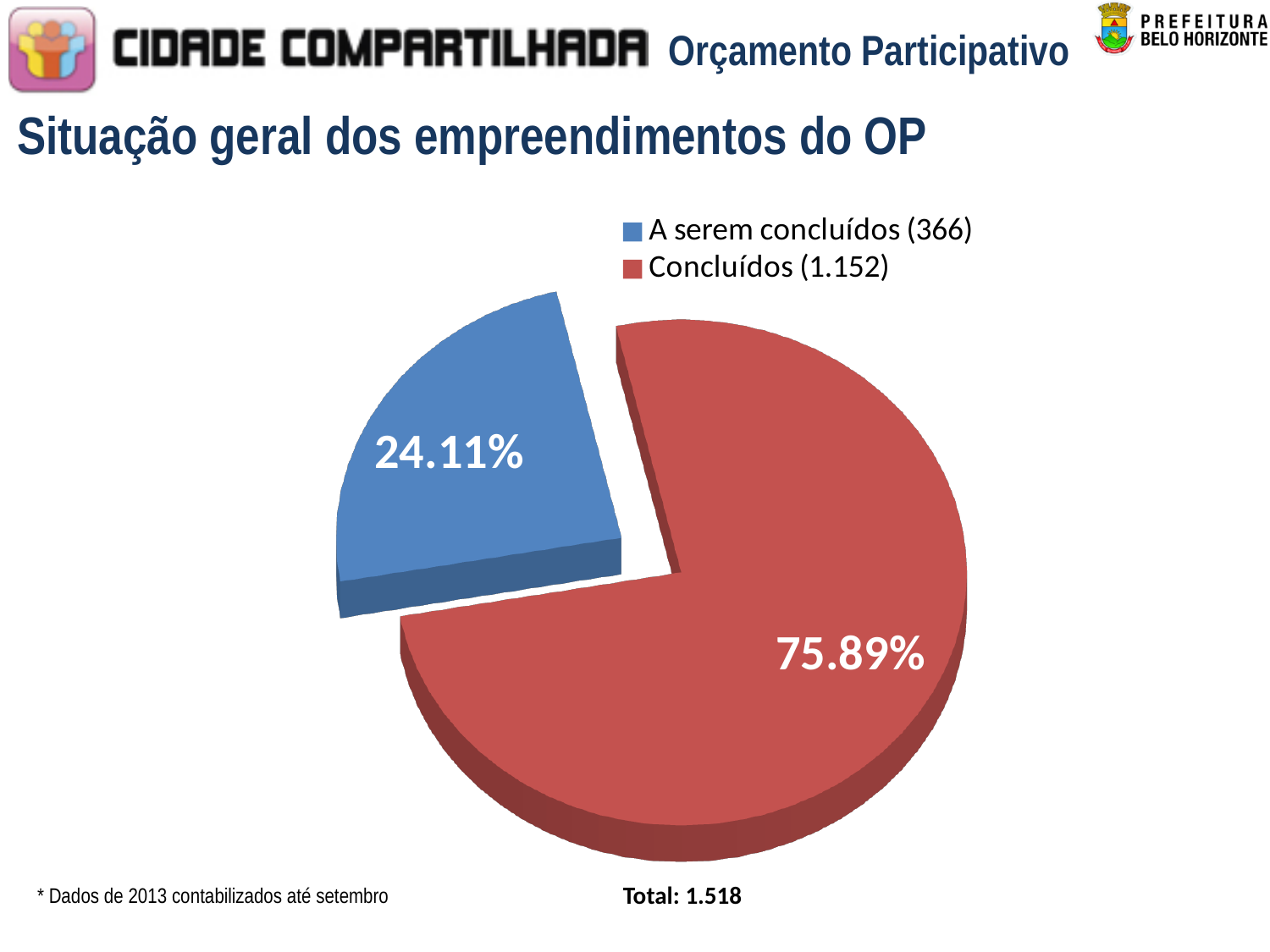
How many entries does the legend list? 2 What is the count shown in the legend for 'Concluídos'? 1.152 What colour is the 'A serem concluídos' slice? blue Which category has the largest share of the pie? Concluídos What percentage share does the 'A serem concluídos' slice have? 24.11% Which is larger, the share for 'Concluídos' or for 'A serem concluídos'? Concluídos What kind of chart is shown on the slide? pie chart What percentage share does the 'Concluídos' slice have? 75.89% How many slices does the pie chart have? 2 Which category has the smallest share of the pie? A serem concluídos What is the count shown in the legend for 'A serem concluídos'? 366 What is the difference in percentage points between the 'Concluídos' and 'A serem concluídos' slices? 51.78